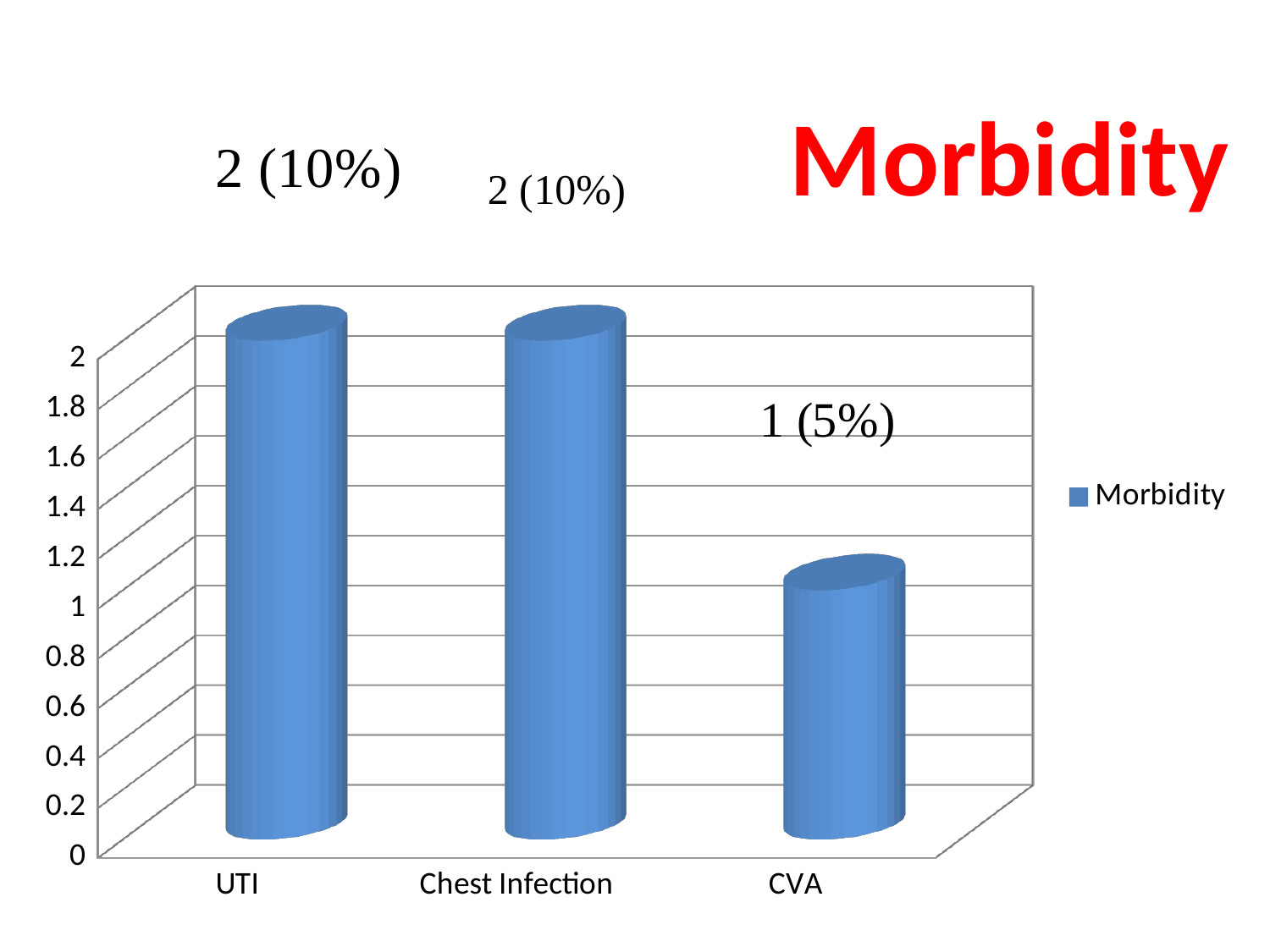
What is the difference between the count for Chest Infection and the count for CVA? 1 Is the value for Chest Infection greater or less than 1.5? greater How many series does the legend list? 1 What is the value shown for UTI? 2 (10%) What is the value shown for CVA? 1 (5%) Which is larger, the value for UTI or the value for CVA? UTI What kind of chart is shown on the slide? bar chart How many categories are shown on the x axis? 3 Is the value for CVA greater or less than 1.5? less What is the title of the slide? Morbidity What is the value shown for Chest Infection? 2 (10%) Which category has the lowest value? CVA